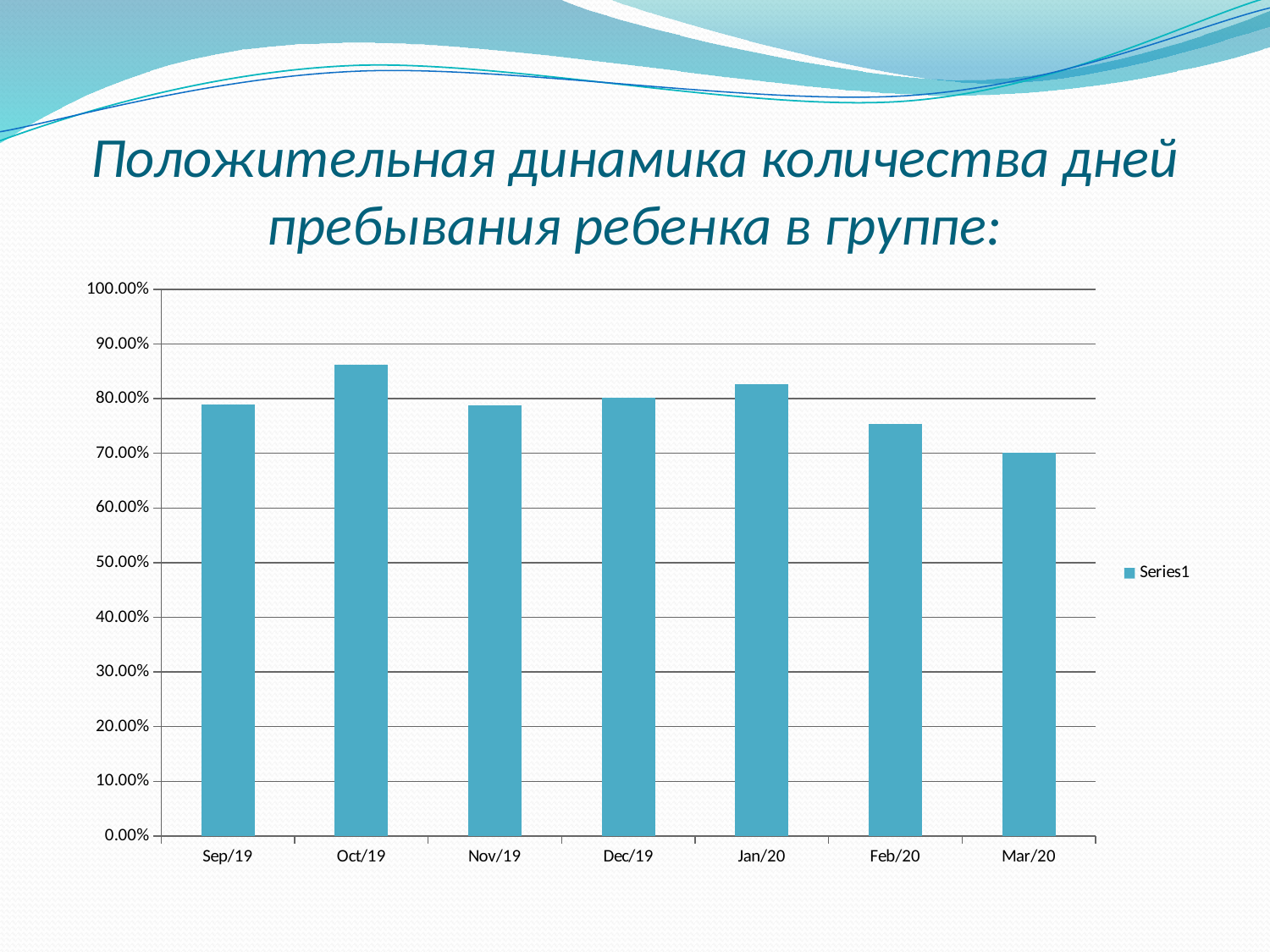
Is the value for Oct/19 greater or less than 80.00%? greater Is the value for Feb/20 greater or less than 80.00%? less Which month has the highest bar in the chart? Oct/19 What is the name of the series shown in the chart legend? Series1 What kind of chart is shown on the slide? bar chart Is the value for Mar/20 greater or less than 80.00%? less Which month has the lowest bar in the chart? Mar/20 How many months are shown on the x axis of the chart? 7 How many series does the chart legend list? 1 Which is larger, the value for Jan/20 or the value for Mar/20? Jan/20 Which is larger, the value for Oct/19 or the value for Feb/20? Oct/19